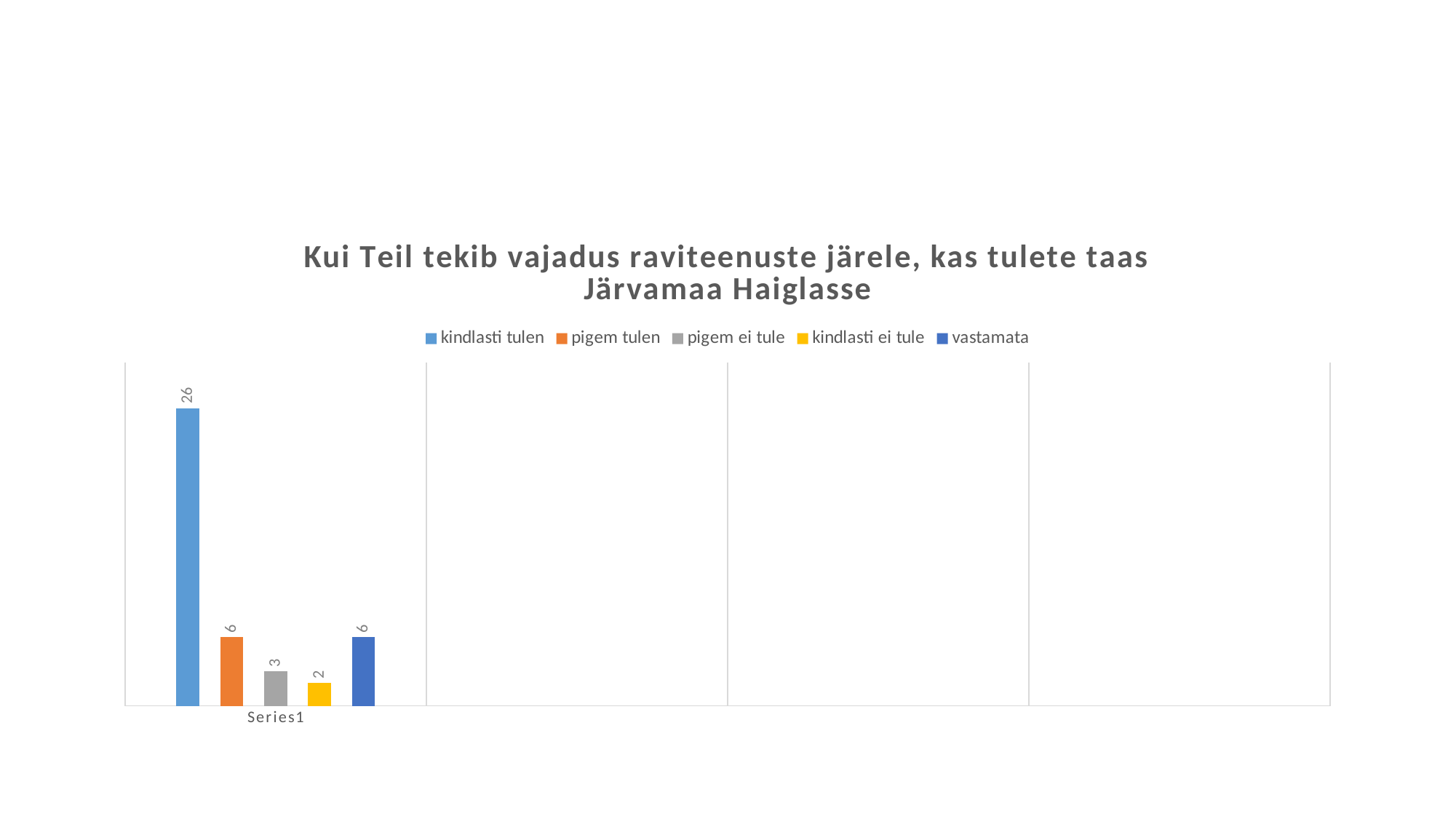
What is the difference between the values for "kindlasti tulen" and "pigem tulen"? 20 What is the value for "vastamata"? 6 What is the title of the chart? Kui Teil tekib vajadus raviteenuste järele, kas tulete taas Järvamaa Haiglasse What is the value for "kindlasti ei tule"? 2 What is the value for "kindlasti tulen"? 26 Which series has the lowest value? kindlasti ei tule What kind of chart is shown on the slide? bar chart Which is larger, the value for "pigem ei tule" or the value for "kindlasti ei tule"? pigem ei tule Which series has the highest value? kindlasti tulen What is the value for "pigem tulen"? 6 How many series does the legend list? 5 What is the value for "pigem ei tule"? 3